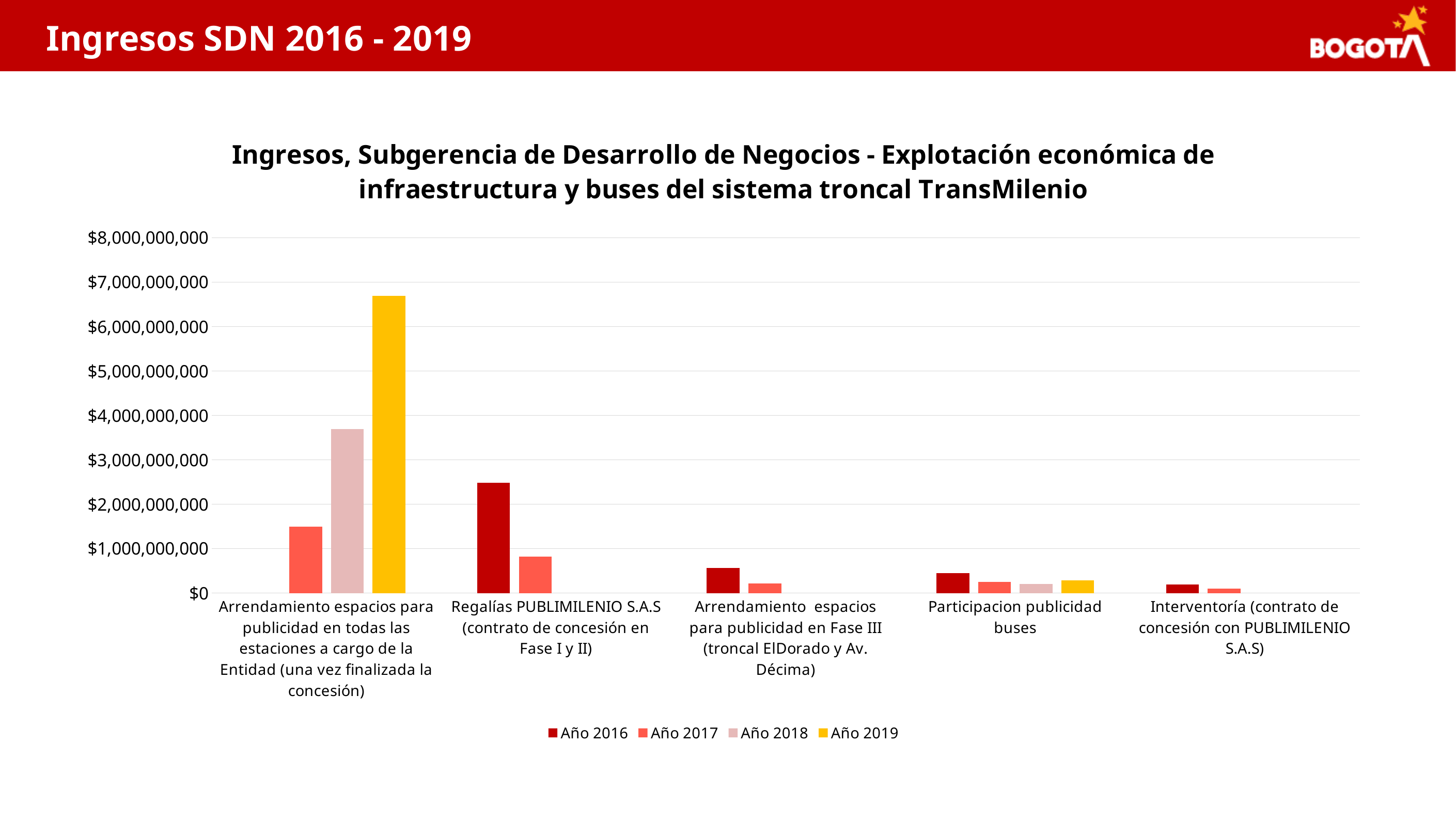
Which category and year has the tallest bar in the chart? Arrendamiento espacios para publicidad en todas las estaciones a cargo de la Entidad, Año 2019 Which is larger: the Año 2018 value for 'Arrendamiento espacios para publicidad en todas las estaciones a cargo de la Entidad' or the Año 2016 value for 'Regalías PUBLIMILENIO S.A.S'? Año 2018 value for Arrendamiento espacios para publicidad en todas las estaciones a cargo de la Entidad How many series does the legend list? 4 Which series does the legend show in yellow? Año 2019 Is the Año 2019 value for 'Arrendamiento espacios para publicidad en todas las estaciones a cargo de la Entidad' greater or less than $6,000,000,000? greater Is the Año 2017 value for 'Regalías PUBLIMILENIO S.A.S (contrato de concesión en Fase I y II)' greater or less than $1,000,000,000? less Is the Año 2016 value for 'Regalías PUBLIMILENIO S.A.S (contrato de concesión en Fase I y II)' greater or less than $2,000,000,000? greater What kind of chart is shown on the slide? Bar chart For 'Arrendamiento espacios para publicidad en todas las estaciones a cargo de la Entidad', do the values rise or fall from Año 2017 to Año 2019? Rise For 'Regalías PUBLIMILENIO S.A.S (contrato de concesión en Fase I y II)', which year has the larger value, Año 2016 or Año 2017? Año 2016 How many categories are shown along the x axis? 5